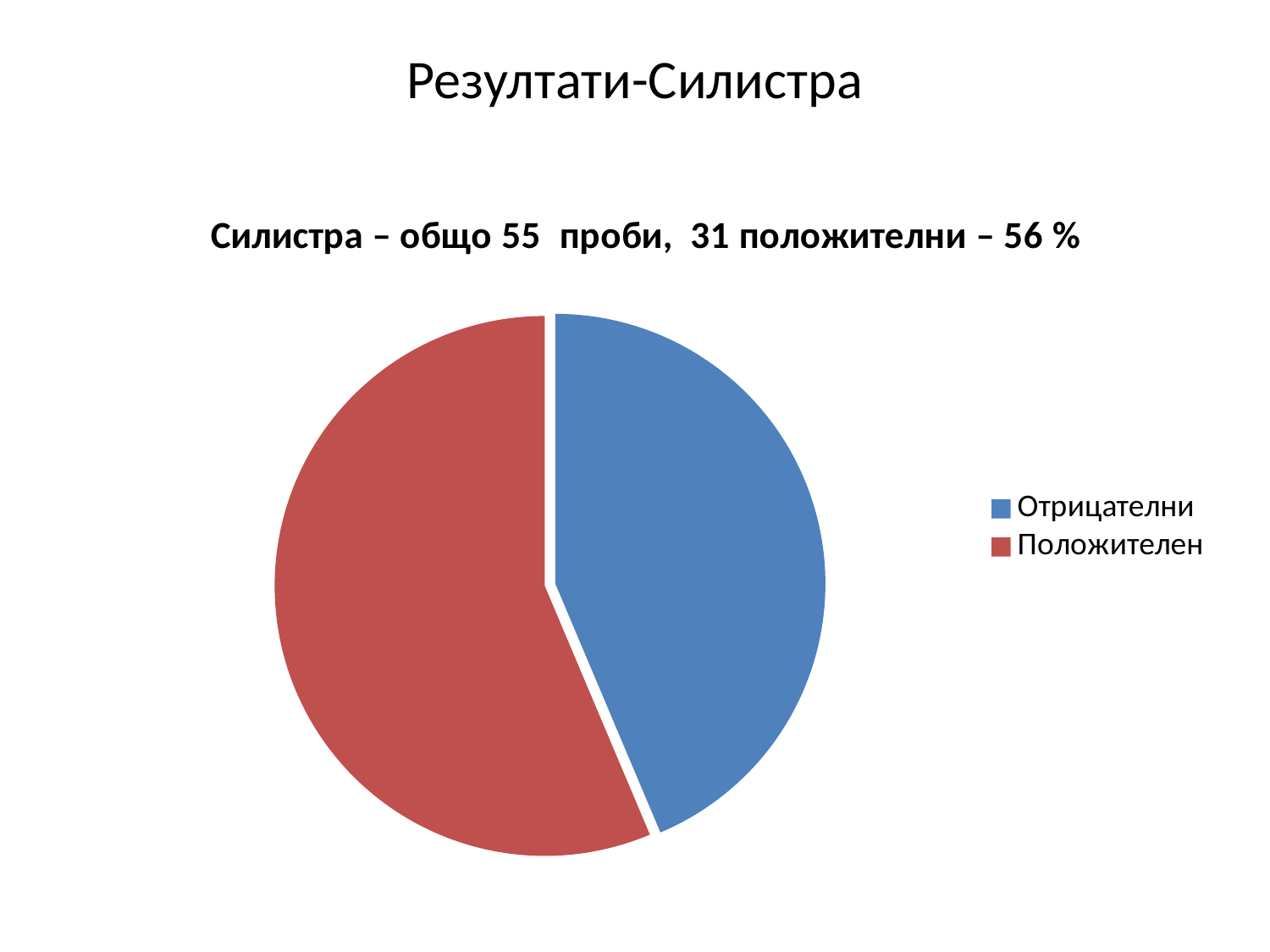
How many slices does the pie chart have? 2 Which slice of the pie chart is the smallest? Отрицателни What colour represents Отрицателни in the pie chart? blue Which is larger in the pie chart, Отрицателни or Положителен? Положителен According to the chart title, how many samples in total were tested in Силистра? 55 Which slice of the pie chart is the largest? Положителен According to the chart title, how many samples were positive (положителни)? 31 How many entries does the legend of the pie chart list? 2 What kind of chart is shown on the slide? pie chart According to the chart title, what share of the samples were positive (положителни)? 56 % What is the title of the pie chart? Силистра – общо 55 проби, 31 положителни – 56 %